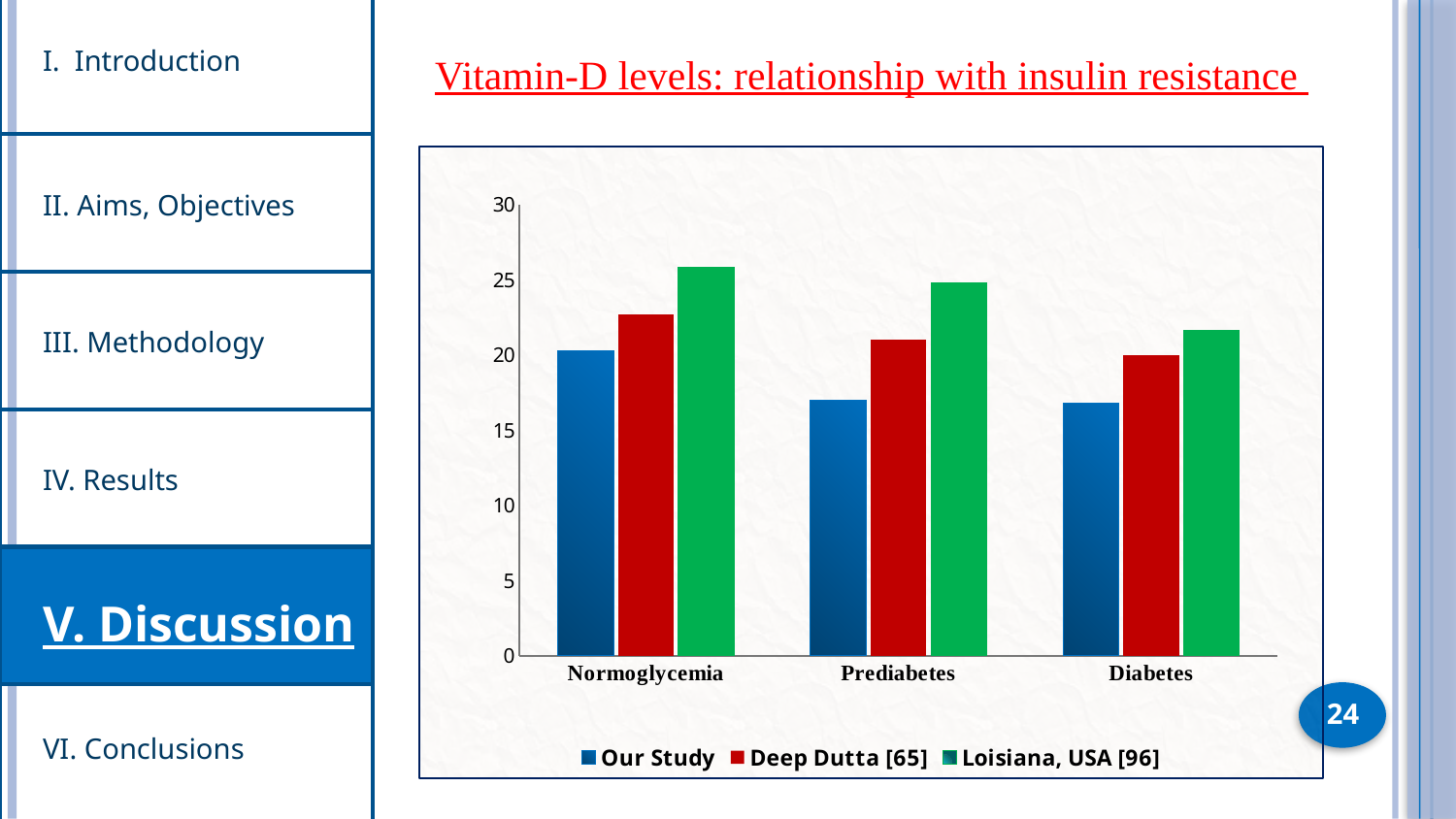
Which series is shown in green in the chart? Loisiana, USA [96] What kind of chart is shown on the slide? bar chart Is the value for Deep Dutta [65] in the Normoglycemia category greater or less than 20? greater Which category has the highest value for the Our Study series? Normoglycemia Which category has the lowest value for the Loisiana, USA [96] series? Diabetes For Prediabetes, which series has the larger value: Our Study or Deep Dutta [65]? Deep Dutta [65] How many categories are shown on the x axis of the chart? 3 Is the value for Our Study in the Prediabetes category greater or less than 20? less What is the title of the chart? Vitamin-D levels: relationship with insulin resistance Do the values for the Loisiana, USA [96] series rise or fall from Normoglycemia to Diabetes? fall How many series does the chart's legend list? 3 Which category has the highest value for the Loisiana, USA [96] series? Normoglycemia